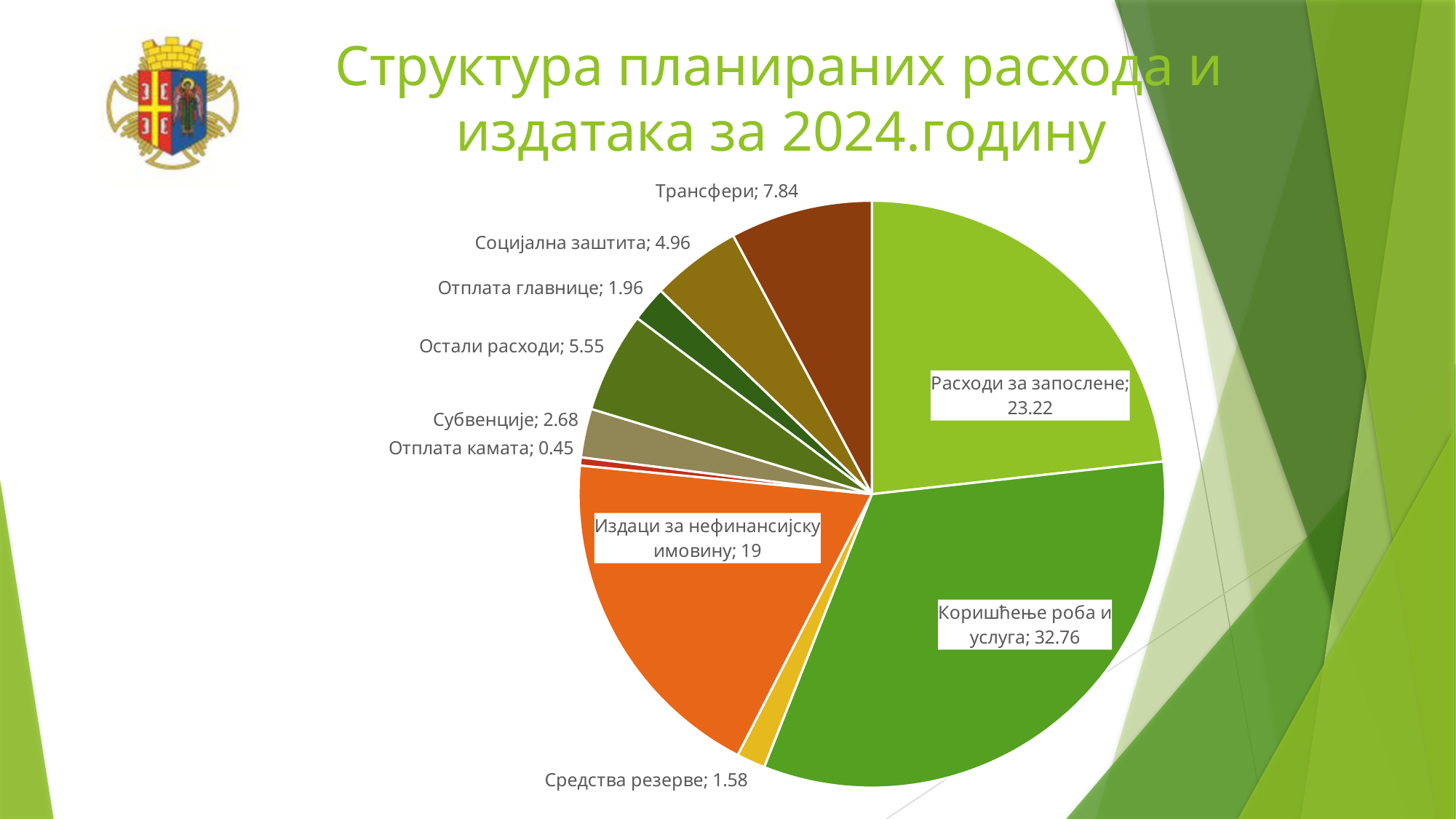
What is the value for Расходи за запослене? 23.22 What type of chart is shown on the slide? pie chart What is the value for Отплата камата? 0.45 What is the value for Трансфери? 7.84 Which category has the largest slice of the pie? Коришћење роба и услуга What is the title of the slide? Структура планираних расхода и издатака за 2024.годину How many categories are shown in the pie chart? 10 Which is larger, the value for Социјална заштита or the value for Остали расходи? Остали расходи What is the value for Издаци за нефинансијску имовину? 19 Which category has the smallest slice of the pie? Отплата камата What is the value for Коришћење роба и услуга? 32.76 What is the difference between the values for Коришћење роба и услуга and Расходи за запослене? 9.54